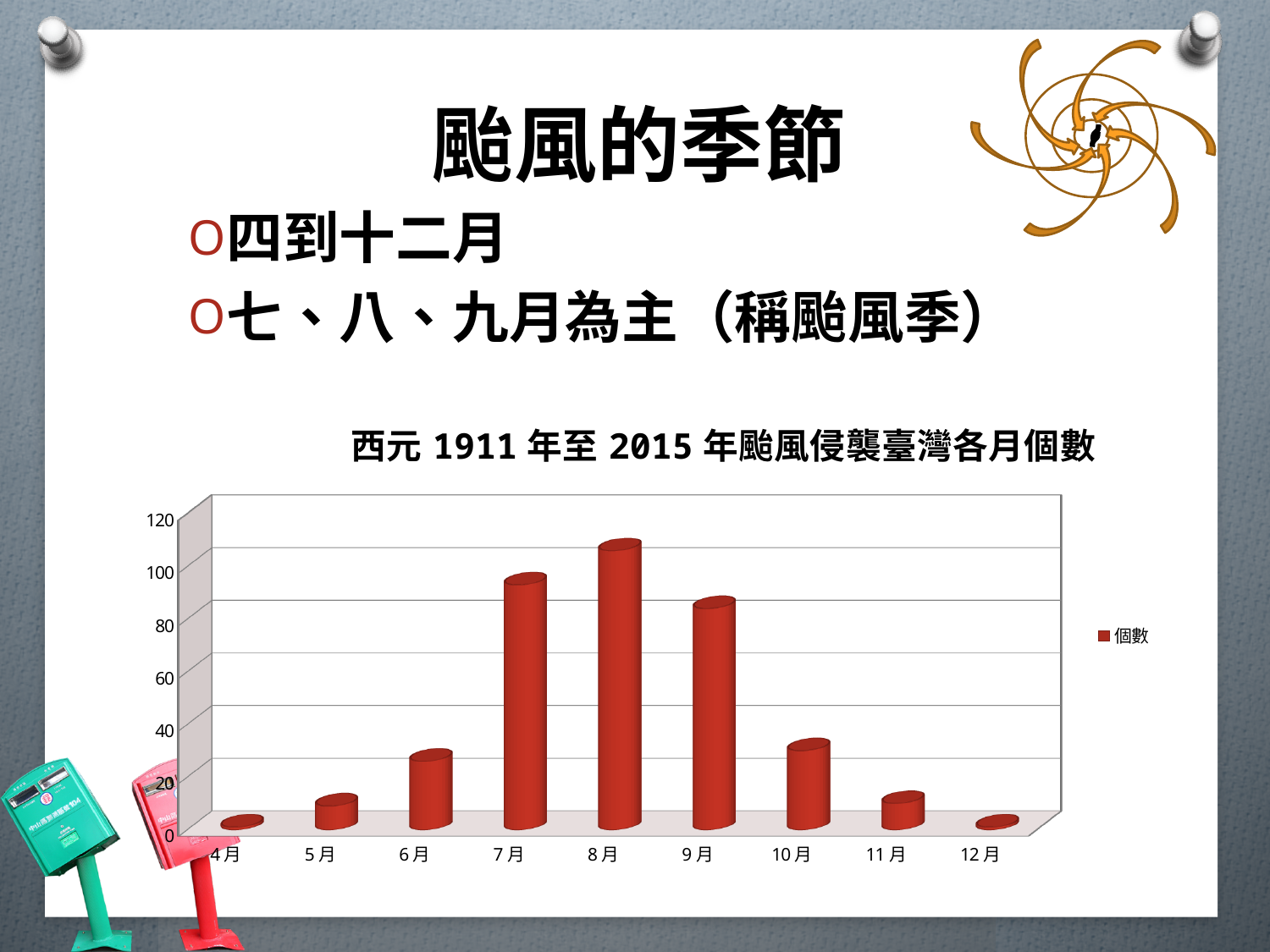
How many months (categories) are shown on the x axis? 9 Is the value for 8月 greater or less than 100? greater What is the name of the series shown in the legend? 個數 Is the value for 9月 greater or less than 100? less How many series does the chart legend list? 1 What is the title of the chart? 西元 1911 年至 2015 年颱風侵襲臺灣各月個數 Which month has the larger value, 7月 or 9月? 7月 Which month has the highest number of typhoons? 8月 What kind of chart is shown on the slide? bar chart Is the value for 7月 greater or less than 80? greater Do the values rise or fall from 4月 to 8月? rise